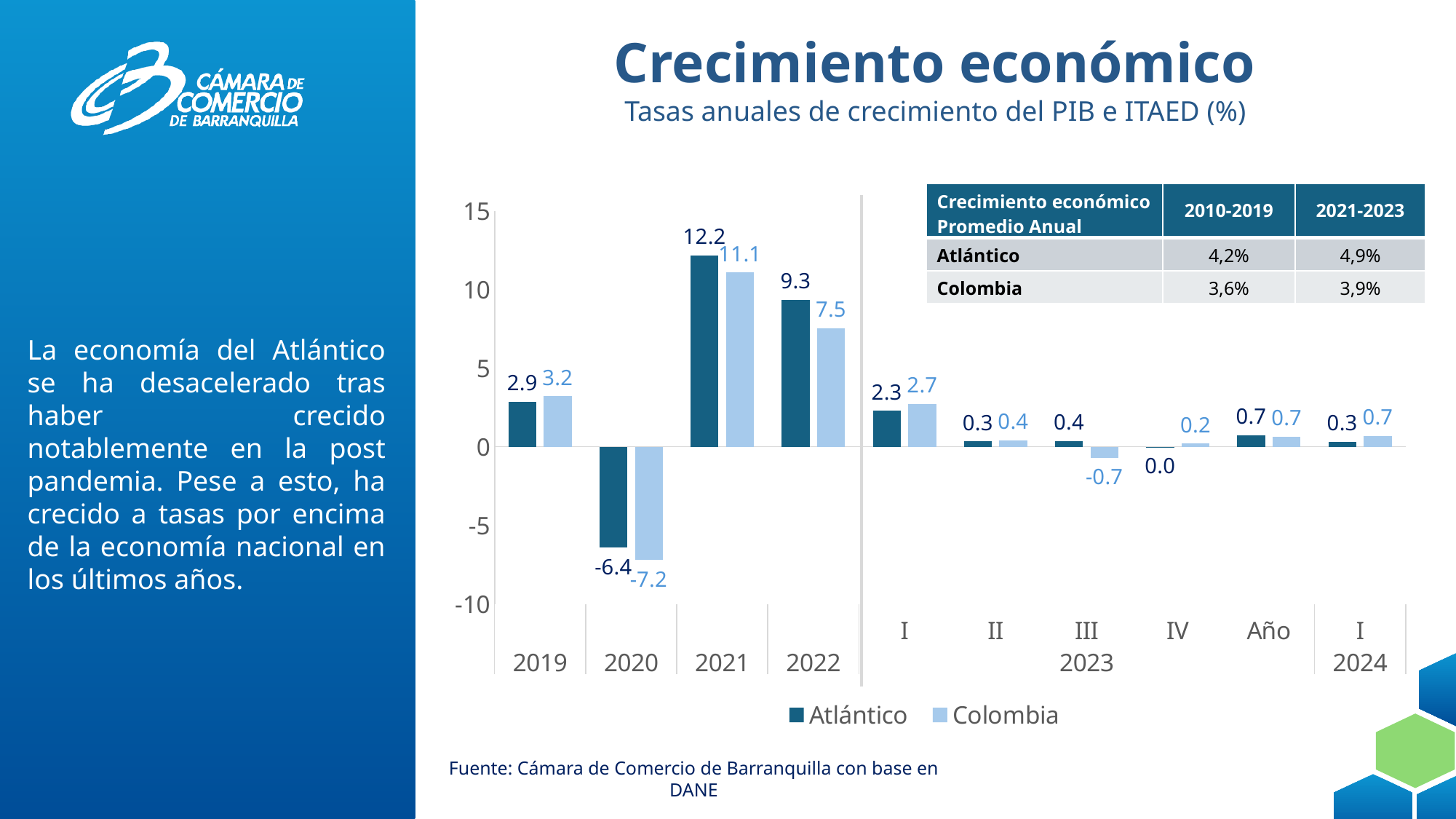
What is the value for Colombia in 2020? -7.2 What is the difference between the Atlántico and Colombia values in 2022? 1.8 Which is larger in 2019, the value for Atlántico or for Colombia? Colombia In which year or period does Atlántico reach its highest value? 2021 In which year or period does Colombia have its lowest value? 2020 What kind of chart is shown on the slide? Bar chart What is the value for Atlántico in 2021? 12.2 According to the table on the chart, what was Atlántico's average annual growth for 2021-2023? 4,9% What is the value for Colombia in quarter III of 2023? -0.7 What is the value for Atlántico in quarter I of 2024? 0.3 How many series does the legend list? 2 How many categories are shown on the x axis of the chart? 10